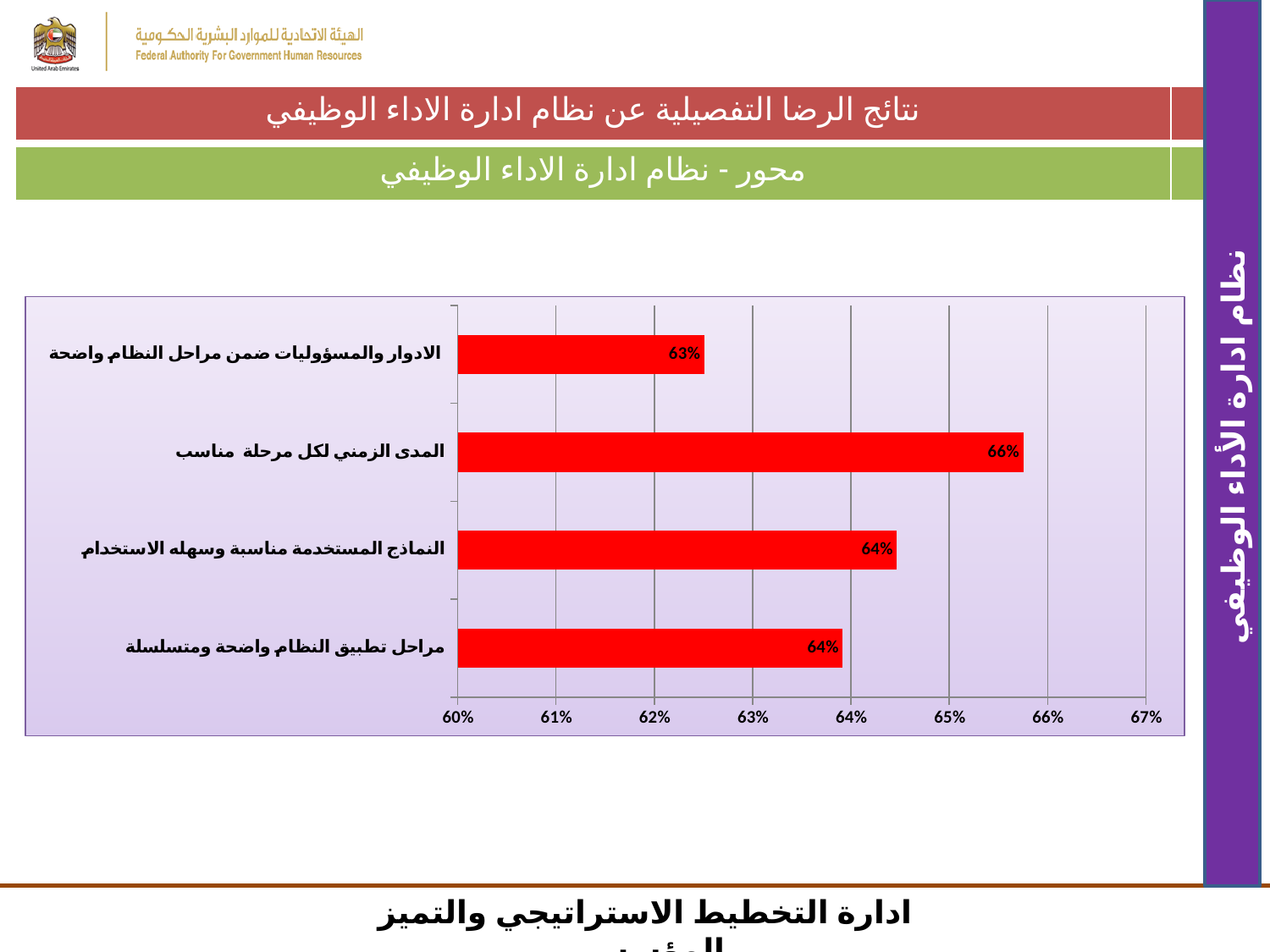
What kind of chart is shown on the slide? Bar chart Which category has the lowest value? الادوار والمسؤوليات ضمن مراحل النظام واضحة What is the value for "الادوار والمسؤوليات ضمن مراحل النظام واضحة"? 63% Is the value for "الادوار والمسؤوليات ضمن مراحل النظام واضحة" greater or less than 64%? less Which category has the highest value? المدى الزمني لكل مرحلة مناسب What is the value for "المدى الزمني لكل مرحلة مناسب"? 66% What is the difference between the values for "المدى الزمني لكل مرحلة مناسب" and "الادوار والمسؤوليات ضمن مراحل النظام واضحة"? 3 percentage points Is the value for "المدى الزمني لكل مرحلة مناسب" greater or less than 65%? greater How many categories are shown in the chart? 4 What is the value for "النماذج المستخدمة مناسبة وسهله الاستخدام"? 64% What is the value for "مراحل تطبيق النظام واضحة ومتسلسلة"? 64% Which is larger, the value for "المدى الزمني لكل مرحلة مناسب" or the value for "النماذج المستخدمة مناسبة وسهله الاستخدام"? المدى الزمني لكل مرحلة مناسب